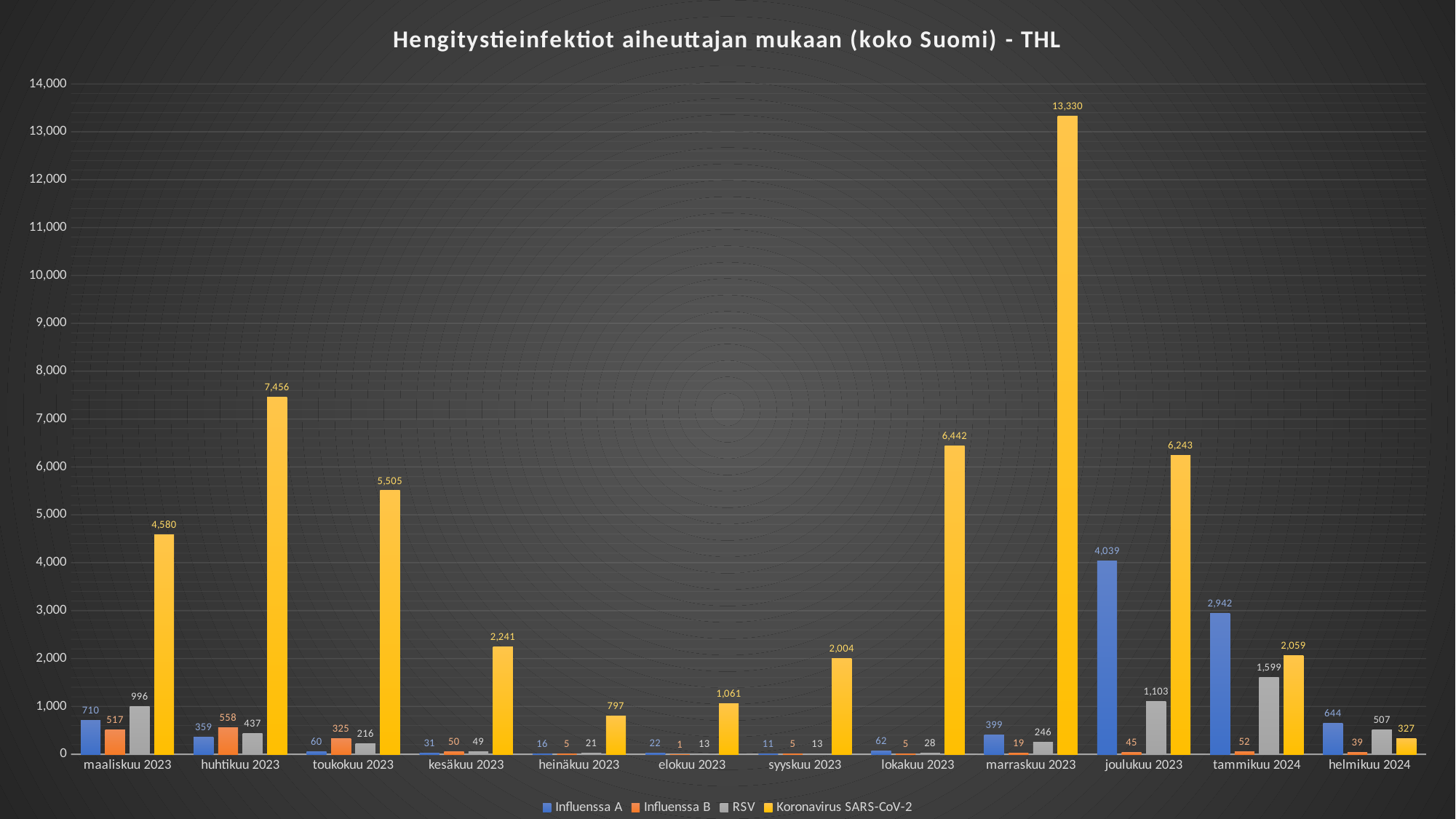
In which month is the Koronavirus SARS-CoV-2 value highest? marraskuu 2023 How many series does the legend list? 4 What is the value for Influenssa A in joulukuu 2023? 4,039 What is the value for Koronavirus SARS-CoV-2 in marraskuu 2023? 13,330 In which month is the Koronavirus SARS-CoV-2 value lowest? helmikuu 2024 How many months are shown on the x axis? 12 What is the difference between the Koronavirus SARS-CoV-2 values for marraskuu 2023 and joulukuu 2023? 7,087 Which is larger in tammikuu 2024: Influenssa A or Koronavirus SARS-CoV-2? Influenssa A What is the value for Influenssa B in huhtikuu 2023? 558 What is the title of the chart? Hengitystieinfektiot aiheuttajan mukaan (koko Suomi) - THL What kind of chart is shown on the slide? Bar chart What is the value for RSV in tammikuu 2024? 1,599